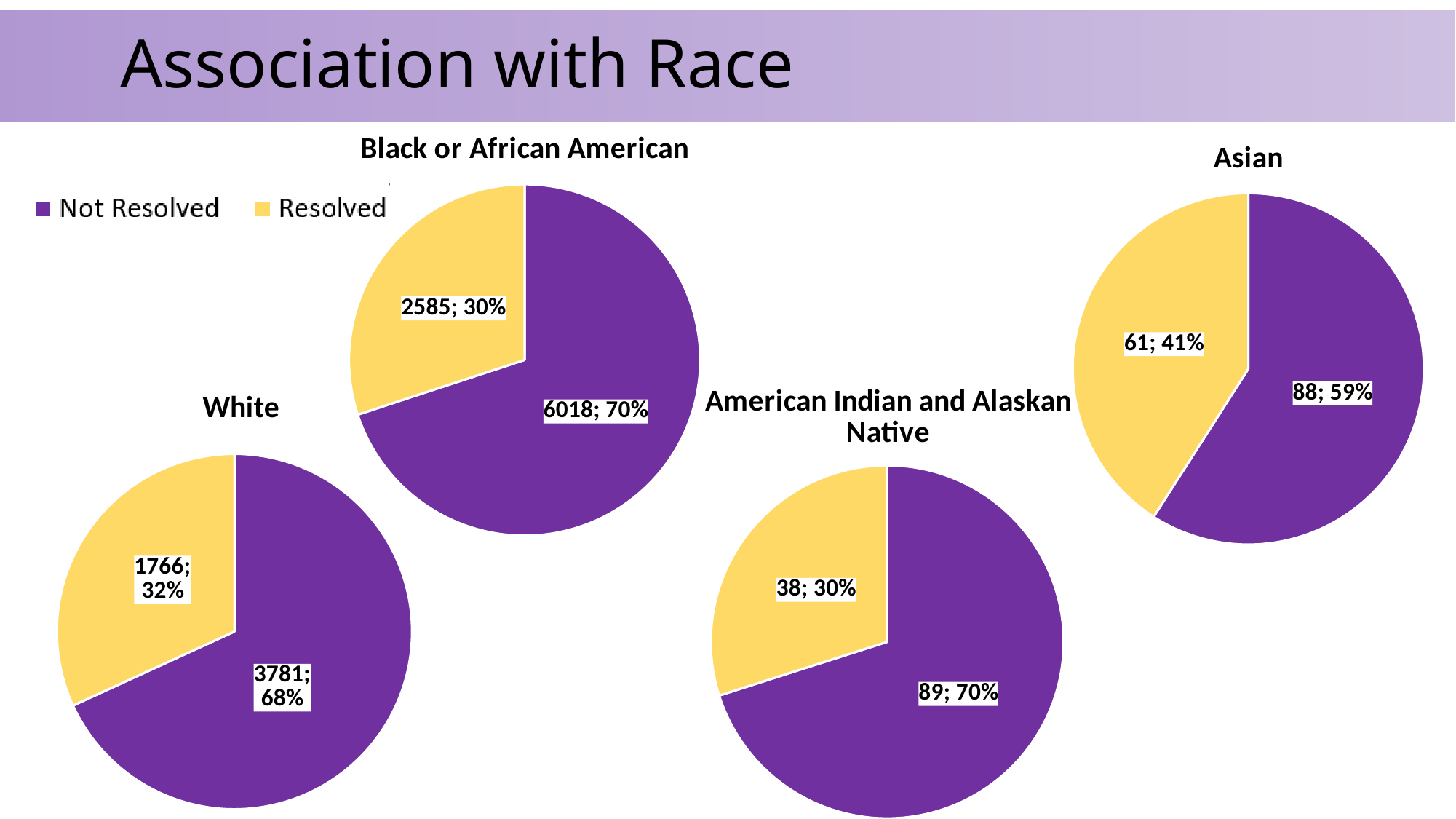
In the "American Indian and Alaskan Native" pie chart, what is the total of the Not Resolved and Resolved counts? 127 In the "Black or African American" pie chart, what is the difference between the Not Resolved count and the Resolved count? 3433 What kind of chart is the "Asian" chart? Pie chart In the "White" pie chart, what is the value for Not Resolved? 3781; 68% In the "White" pie chart, what share of the pie is Resolved? 32% In the "American Indian and Alaskan Native" pie chart, what is the value for Resolved? 38; 30% How many series does the legend list? 2 In the "Asian" pie chart, what is the value for Not Resolved? 88; 59% How many pie charts are shown on the slide? 4 In the "Asian" pie chart, what share of the pie is Resolved? 41% In the "Black or African American" pie chart, what is the value for Resolved? 2585; 30% In the "Black or African American" pie chart, which slice is larger, Not Resolved or Resolved? Not Resolved